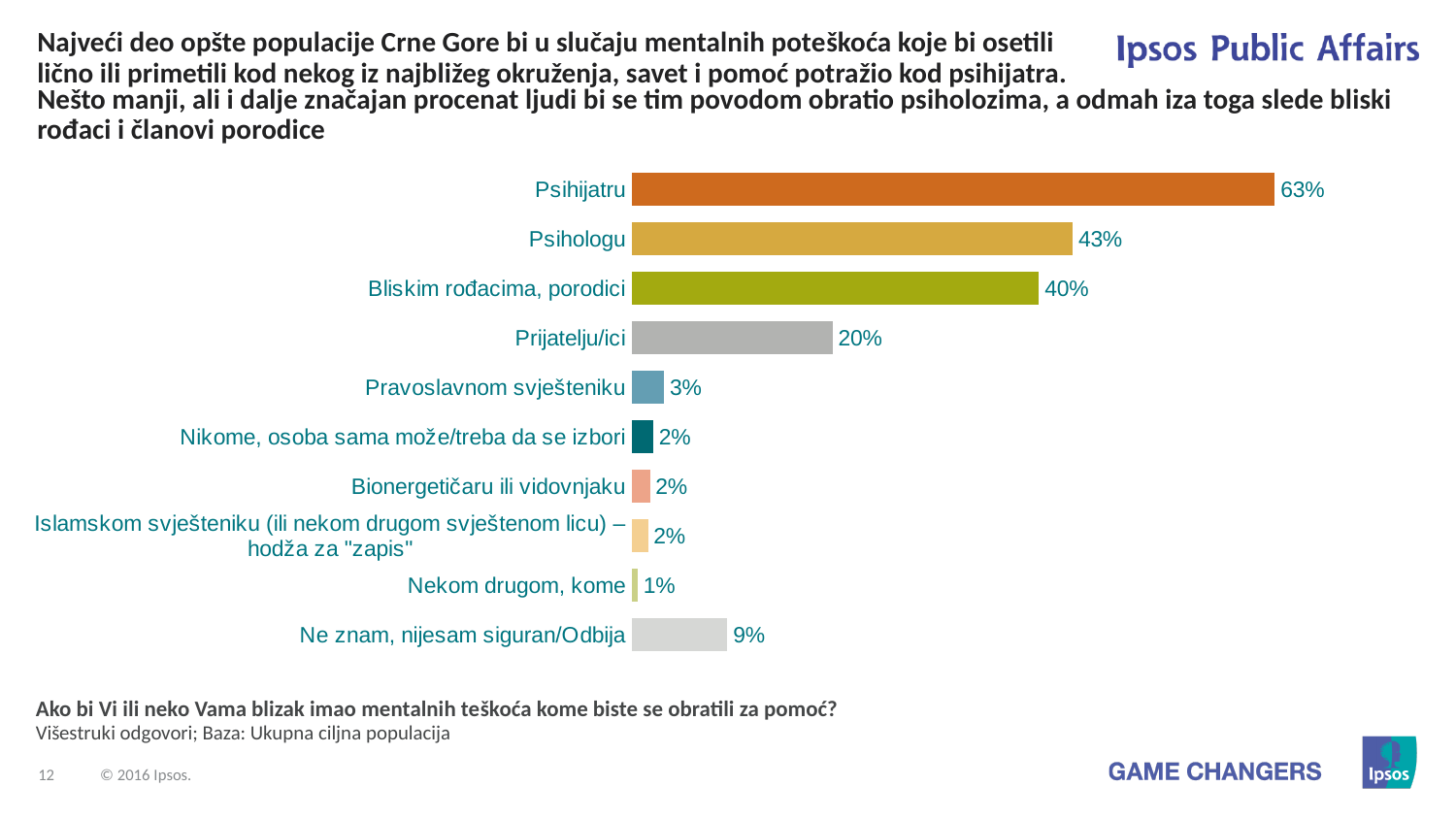
Which category has the highest value? Psihijatru What is the difference between the values for Bliskim rođacima, porodici and Prijatelju/ici? 20 percentage points What percentage of respondents would turn to a psychiatrist (Psihijatru)? 63% Which is larger, the value for Psihologu or the value for Bliskim rođacima, porodici? Psihologu What is the value shown for Psihologu? 43% What is the difference between the values for Psihijatru and Psihologu? 20 percentage points Which category has the lowest value? Nekom drugom, kome How many categories are shown in the chart? 10 What is the value shown for Prijatelju/ici? 20% What type of chart is shown on the slide? Bar chart What is the value shown for Pravoslavnom svješteniku? 3% What is the value shown for Ne znam, nijesam siguran/Odbija? 9%